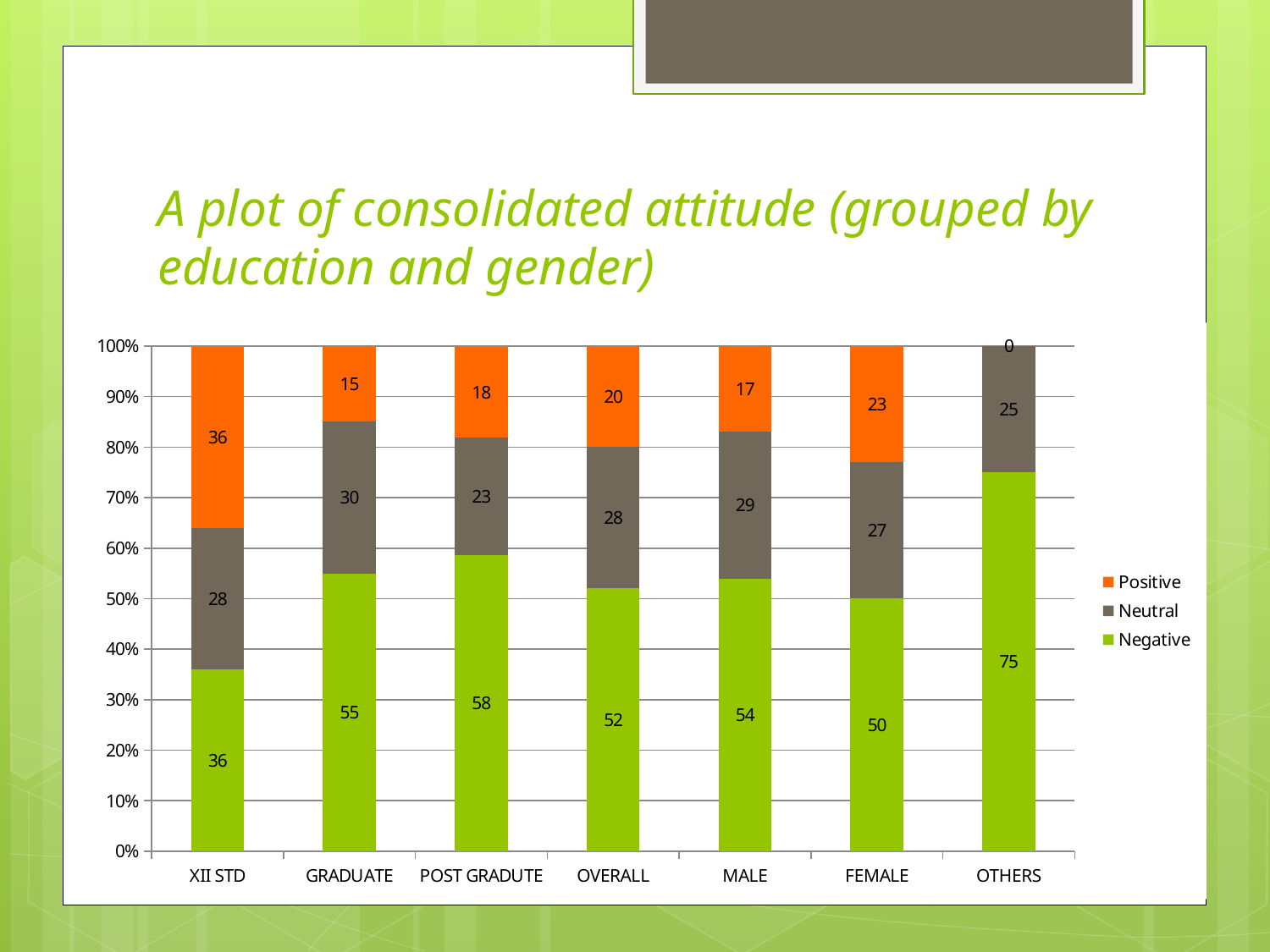
What is the Negative value for OTHERS? 75 Which series is shown in orange in the legend? Positive How many series does the legend list? 3 Which category has the highest Negative value? OTHERS What kind of chart is shown on the slide? Stacked bar chart What is the Neutral value for GRADUATE? 30 Which category has the lowest Positive value? OTHERS Which is larger, the Neutral value for XII STD or the Neutral value for POST GRADUTE? XII STD How many categories are shown on the x axis? 7 What is the Positive value for XII STD? 36 What is the Positive value for FEMALE? 23 What is the difference between the Negative values for MALE and FEMALE? 4